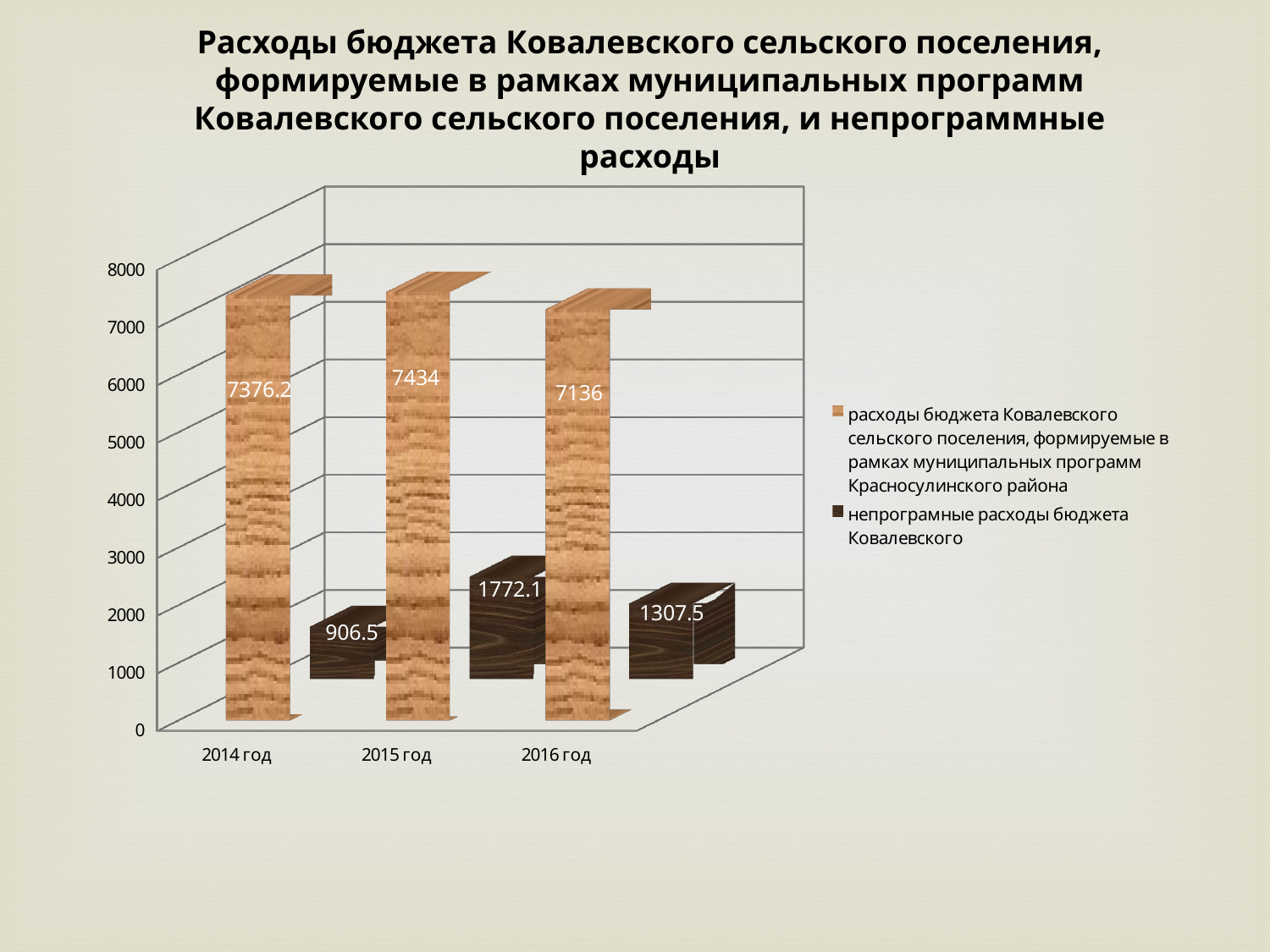
What is the difference between the programme-based expenses in 2015 год and 2016 год? 298 Do the non-programme expenses rise or fall from 2015 год to 2016 год? Fall What is the value of the non-programme expenses (непрограмные расходы) for 2015 год? 1772.1 What is the value of the non-programme expenses (непрограмные расходы) for 2016 год? 1307.5 Which is larger: the programme-based expenses in 2014 год or in 2015 год? 2015 год What is the difference between the non-programme expenses in 2015 год and 2014 год? 865.6 In which year are the programme-based budget expenses the highest? 2015 год What is the value of the programme-based budget expenses (расходы бюджета, формируемые в рамках муниципальных программ) for 2014 год? 7376.2 What kind of chart is shown on the slide? Bar chart In which year are the non-programme expenses the lowest? 2014 год How many years (categories) are shown on the x axis? 3 How many series does the legend list? 2